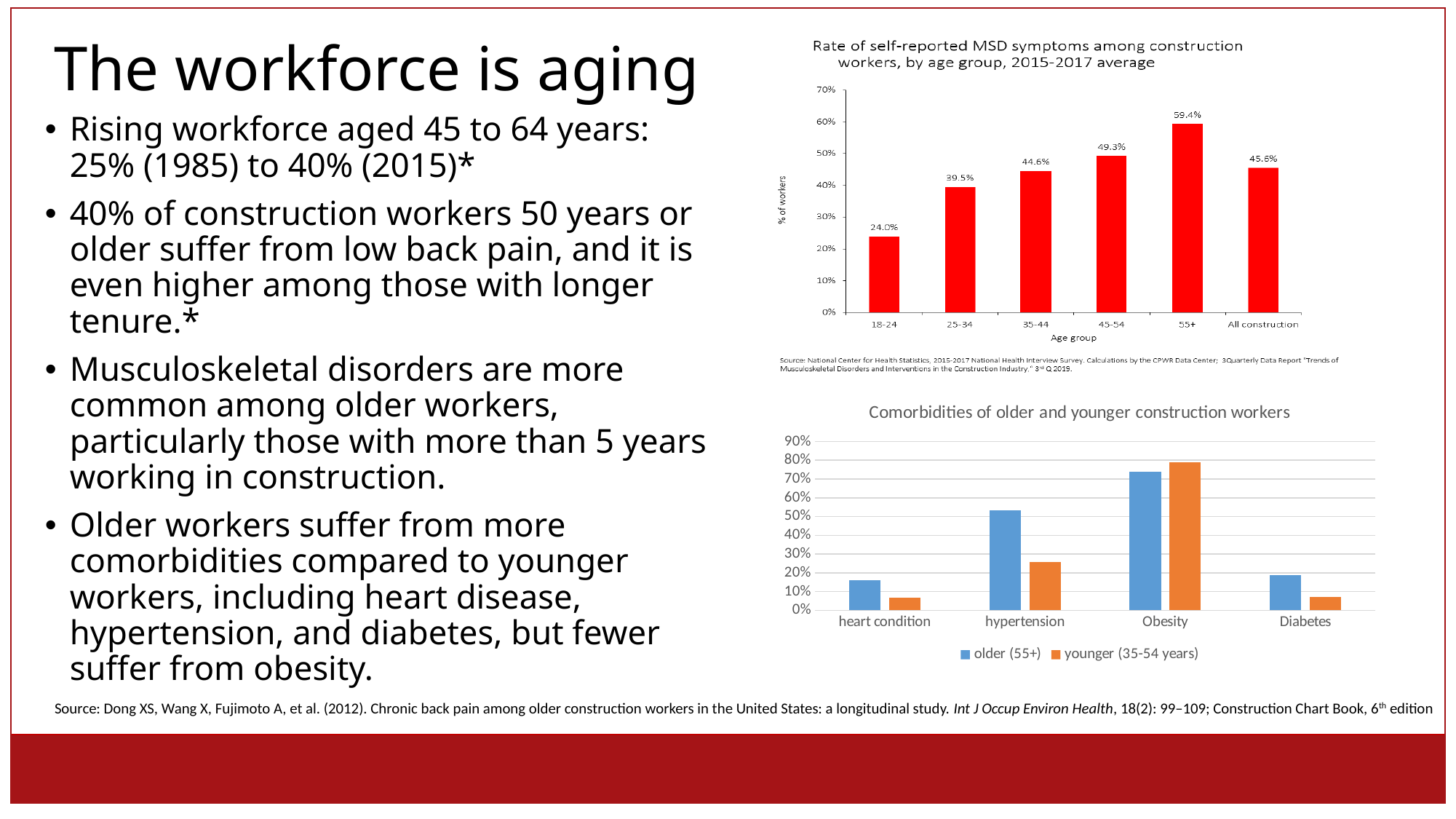
In the chart 'Rate of self-reported MSD symptoms among construction workers, by age group, 2015-2017 average', what is the value for All construction? 45.6% In the chart 'Rate of self-reported MSD symptoms among construction workers, by age group, 2015-2017 average', which age group has the lowest rate? 18-24 In the chart 'Rate of self-reported MSD symptoms among construction workers, by age group, 2015-2017 average', what is the value for the 55+ age group? 59.4% In the chart 'Comorbidities of older and younger construction workers', which group has the larger value for Obesity, older (55+) or younger (35-54 years)? younger (35-54 years) In the chart 'Rate of self-reported MSD symptoms among construction workers, by age group, 2015-2017 average', which age group has the highest rate? 55+ In the chart 'Rate of self-reported MSD symptoms among construction workers, by age group, 2015-2017 average', what is the difference between the 45-54 and 35-44 age groups? 4.7% In the chart 'Comorbidities of older and younger construction workers', is the value for hypertension among older (55+) workers greater or less than 40%? greater In the chart 'Rate of self-reported MSD symptoms among construction workers, by age group, 2015-2017 average', do the values rise or fall from the 18-24 group to the 55+ group? rise In the chart 'Rate of self-reported MSD symptoms among construction workers, by age group, 2015-2017 average', what is the value for the 18-24 age group? 24.0% In the chart 'Comorbidities of older and younger construction workers', how many series does the legend list? 2 In the chart 'Rate of self-reported MSD symptoms among construction workers, by age group, 2015-2017 average', how many bars are plotted? 6 What kind of chart is 'Comorbidities of older and younger construction workers'? bar chart